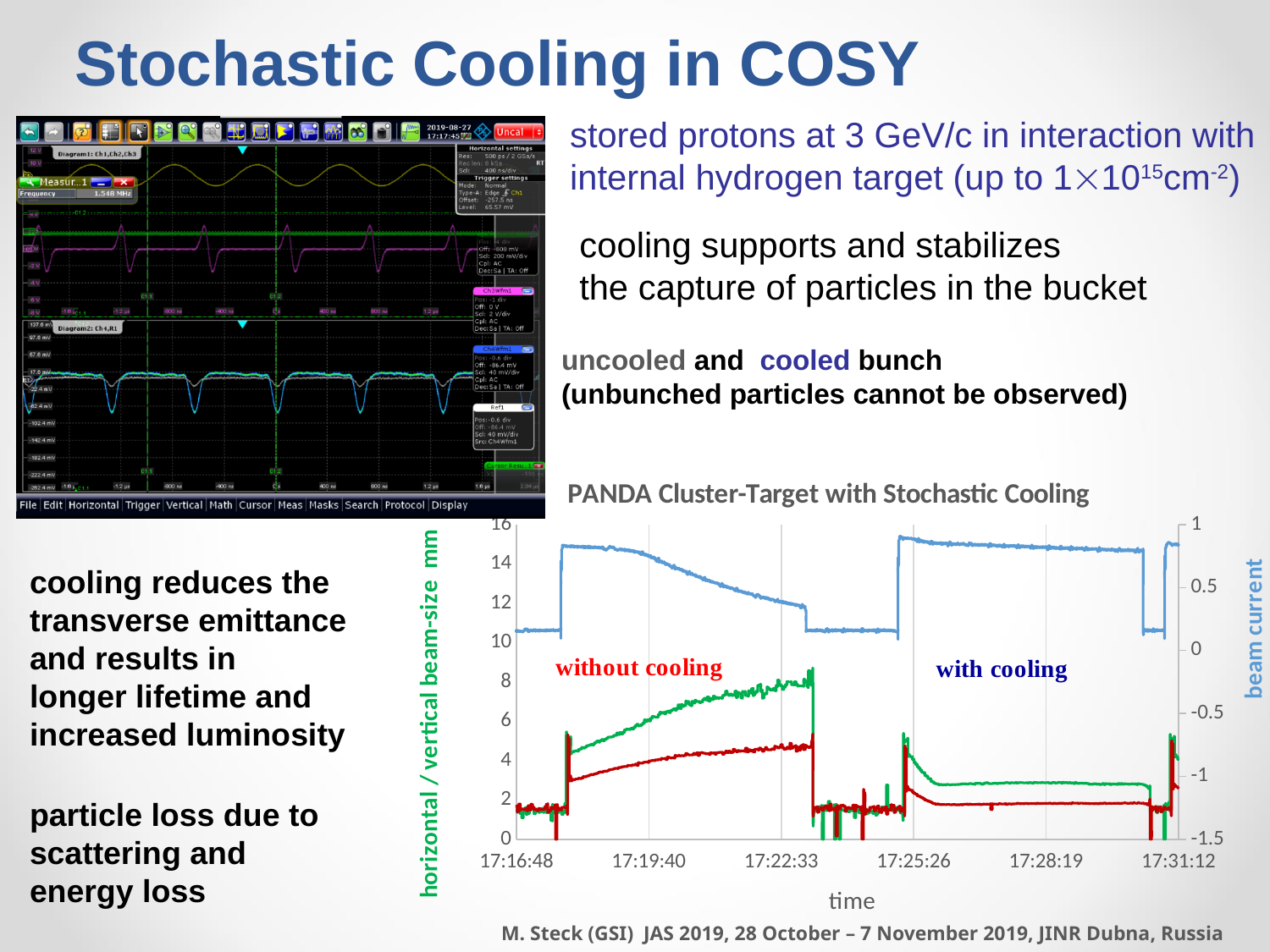
In the 'PANDA Cluster-Target with Stochastic Cooling' chart, does the green line rise or fall between 17:19:40 and 17:22:33 in the 'without cooling' region? rise In the 'PANDA Cluster-Target with Stochastic Cooling' chart, does the blue beam current line rise or fall between 17:19:40 and 17:22:33? fall In the 'PANDA Cluster-Target with Stochastic Cooling' chart, is the green line's level in the 'with cooling' region around 17:28:19 greater or less than 4 mm? less In the 'PANDA Cluster-Target with Stochastic Cooling' chart, which line is higher in the 'without cooling' region just before 17:22:33, the green line or the red line? green line In the oscilloscope screenshot on the left of the slide, what frequency is shown in the measurement box? 1.548 MHz In the 'PANDA Cluster-Target with Stochastic Cooling' chart, what is the label of the left vertical axis? horizontal / vertical beam-size mm In the 'PANDA Cluster-Target with Stochastic Cooling' chart, is the red line's level in the 'with cooling' region around 17:28:19 greater or less than 4 mm? less In the 'PANDA Cluster-Target with Stochastic Cooling' chart, how many time labels are printed along the x axis? 6 In the 'PANDA Cluster-Target with Stochastic Cooling' chart, what is the maximum value shown on the right 'beam current' axis? 1 What kind of chart is the 'PANDA Cluster-Target with Stochastic Cooling' chart? line chart What is the title of the chart at the bottom right of the slide? PANDA Cluster-Target with Stochastic Cooling In the 'PANDA Cluster-Target with Stochastic Cooling' chart, is the peak of the green line just before 17:22:33 greater or less than 6 mm? greater